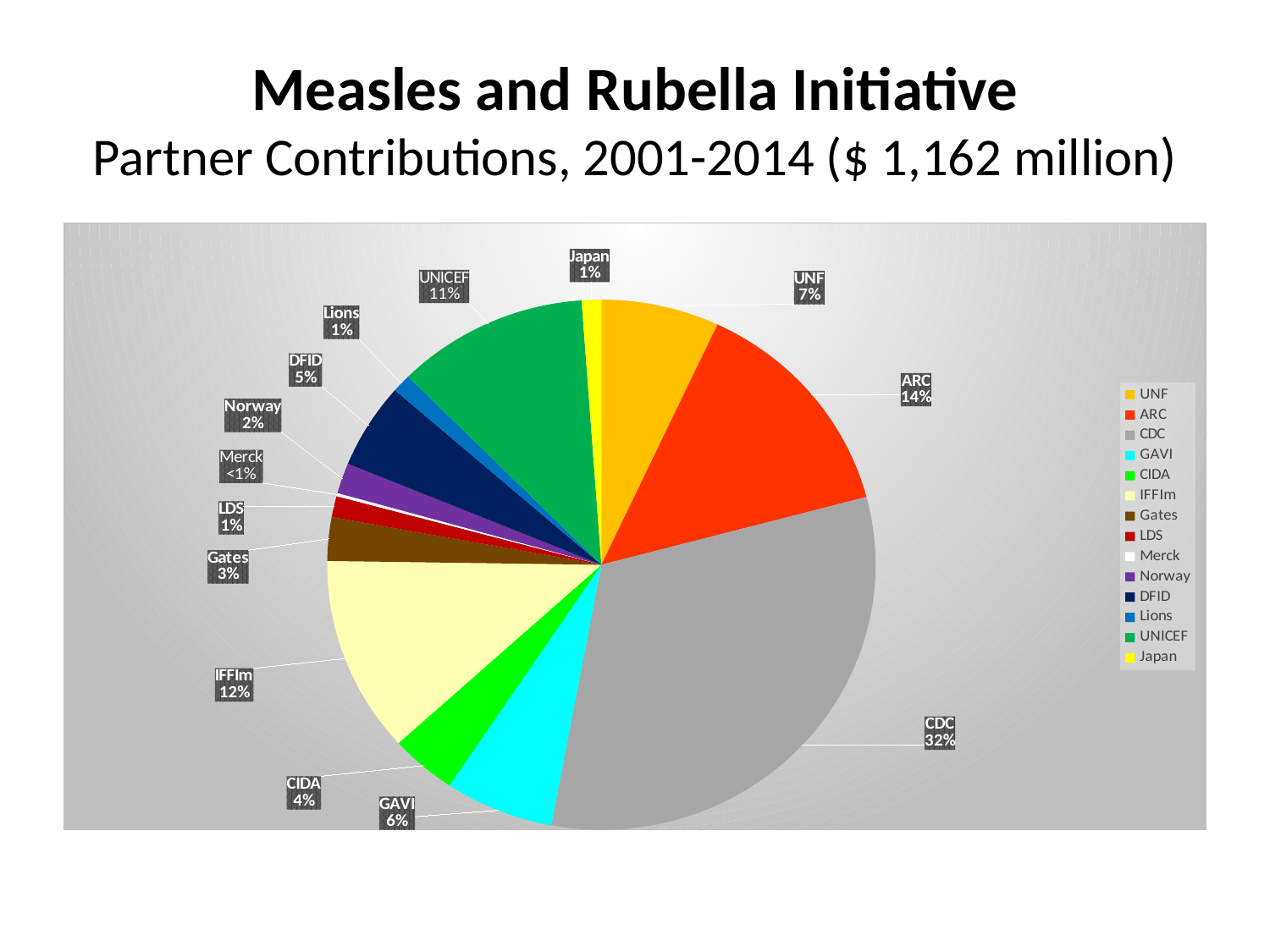
What share of partner contributions does UNICEF account for? 11% What share of partner contributions does ARC account for? 14% What is the difference in percentage points between the shares of CDC and ARC? 18 What share of partner contributions does CDC account for? 32% Which partner has a larger share, UNF or GAVI? UNF Which partner has the smallest share of contributions? Merck Which partner has the largest share of contributions? CDC How many partners are listed in the legend? 14 What total amount of partner contributions is stated in the slide title? $ 1,162 million What kind of chart is shown on the slide? Pie chart